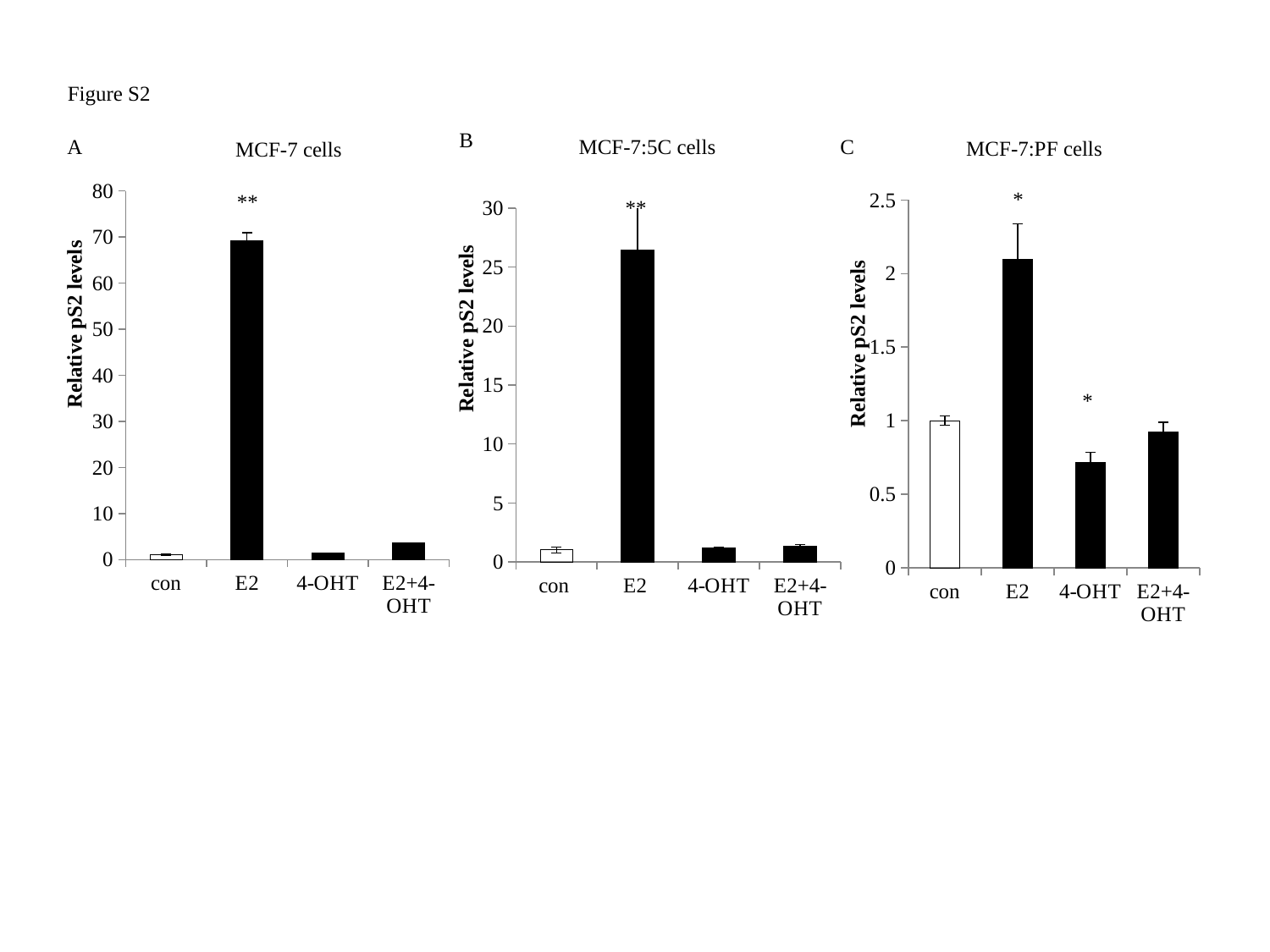
What is the title of the chart in panel B? MCF-7:5C cells How many categories are shown on the x axis of the MCF-7:5C cells chart (panel B)? 4 In the MCF-7 cells chart (panel A), which category has the highest relative pS2 level? E2 What kind of chart is the MCF-7 cells chart (panel A)? bar chart In the MCF-7:PF cells chart (panel C), is the value for E2 greater or less than 2? greater In the MCF-7:PF cells chart (panel C), which category has the lowest relative pS2 level? 4-OHT What is the y-axis label of the MCF-7:PF cells chart (panel C)? Relative pS2 levels In the MCF-7 cells chart (panel A), is the value for E2+4-OHT greater or less than 10? less In the MCF-7:5C cells chart (panel B), which category has the highest relative pS2 level? E2 In the MCF-7 cells chart (panel A), is the value for E2 greater or less than 60? greater In the MCF-7:PF cells chart (panel C), which is larger, the value for con or the value for 4-OHT? con